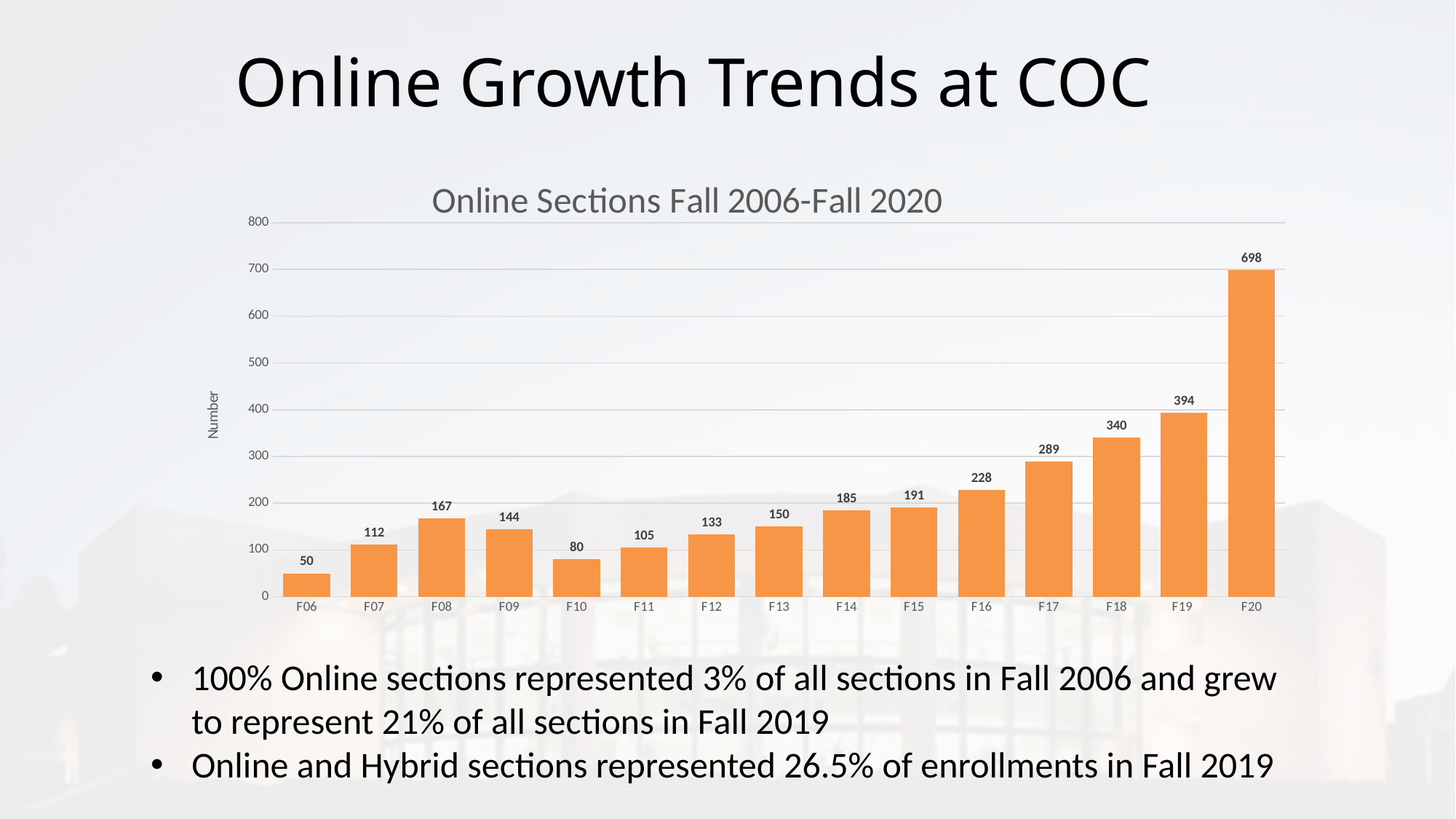
What is the difference in online sections between F20 and F19? 304 What is the number of online sections for F20? 698 Is the value for F17 greater or less than 300? less How many terms are shown on the x axis of the chart? 15 Which has more online sections, F08 or F09? F08 Do the values generally rise or fall from F10 to F20? rise What is the title of the chart? Online Sections Fall 2006-Fall 2020 Which term has the lowest number of online sections? F06 What is the number of online sections for F06? 50 What is the number of online sections for F10? 80 What kind of chart is shown on the slide? bar chart Which term has the highest number of online sections? F20